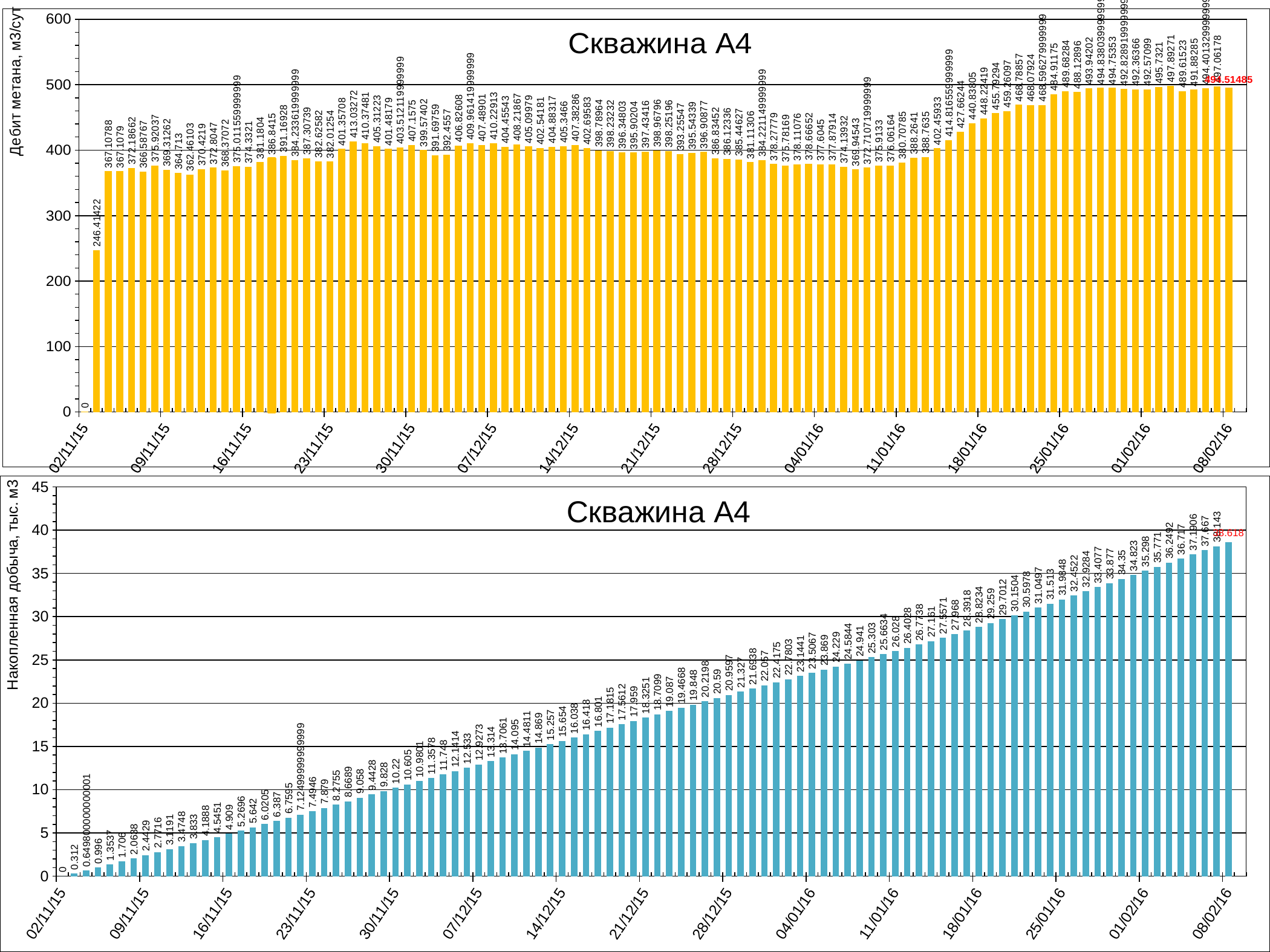
On the bottom chart (Накопленная добыча), what is the difference between the last bar (38.618) and the bar before it (38.143)? 0.475 On the top chart (Дебит метана), what is the highest labelled value? 497.89271 On the bottom chart (Накопленная добыча), what is the value of the last (red-labelled) bar at 08/02/16? 38.618 On the bottom chart (Накопленная добыча), do the values rise or fall from left to right along the x axis? rise On the top chart (Дебит метана), what is the value of the last (red-labelled) bar at 08/02/16? 494.51485 On the bottom chart (Накопленная добыча), what is the highest value shown? 38.618 On the top chart (Дебит метана), what is the value of the second bar, the first non-zero one? 246.41422 On the bottom chart (Накопленная добыча), what is the value of the first bar at 02/11/15? 0 On the top chart (Дебит метана), which is larger: the second bar (246.41422) or the third bar (367.10788)? 367.10788 On the top chart (Дебит метана), is the value of the bar at 09/11/15 greater or less than 300? greater What is the y-axis label of the bottom chart? Накопленная добыча, тыс. м3 What kind of chart is the top chart titled Скважина А4? bar chart